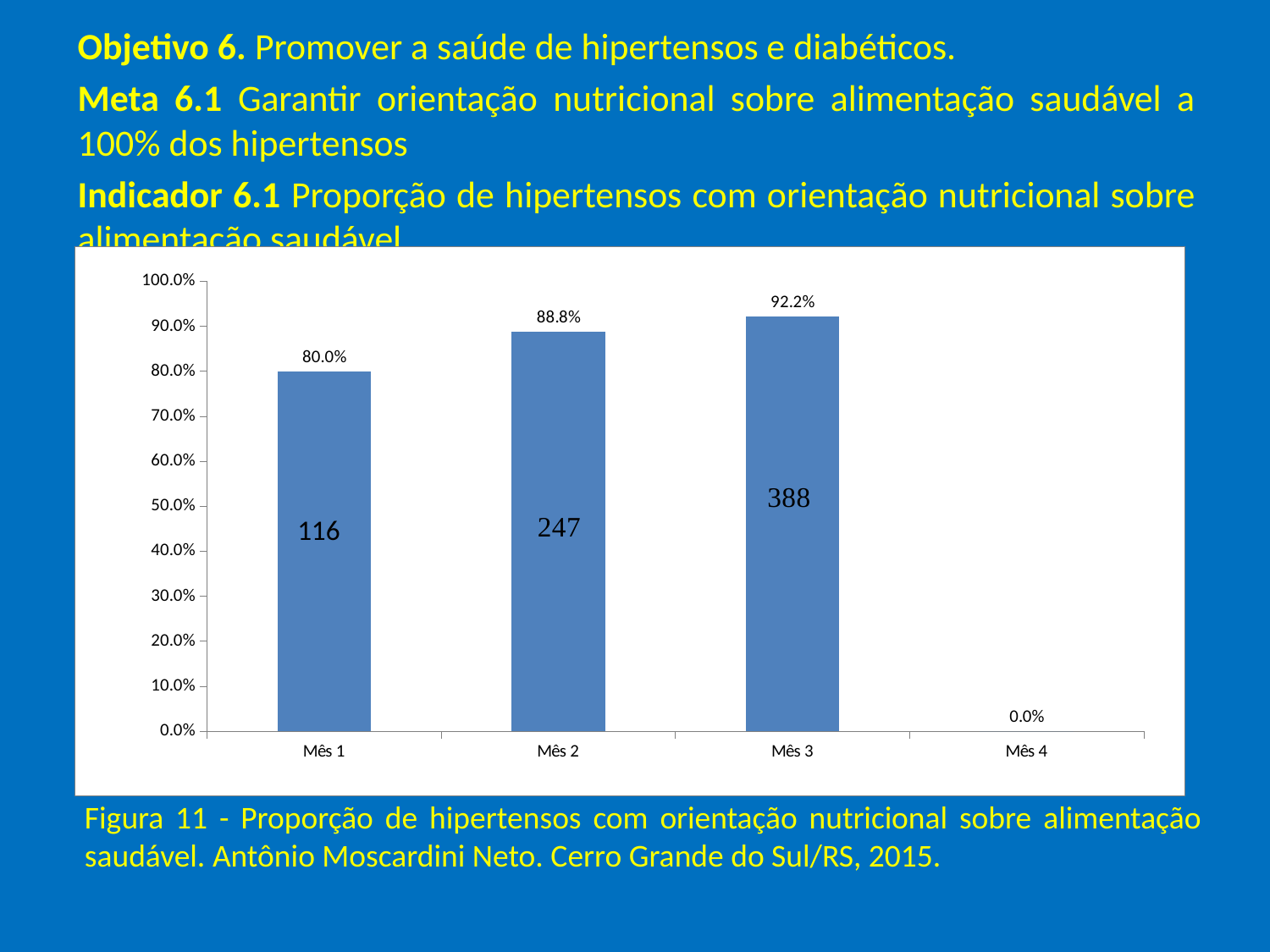
Which month has the lowest value? Mês 4 What is the difference between the values for Mês 3 and Mês 1? 12.2% What is the value for Mês 4? 0.0% What is the value for Mês 2? 88.8% What is the value for Mês 1? 80.0% Which is larger, the value for Mês 2 or the value for Mês 1? Mês 2 Which month has the highest value? Mês 3 What kind of chart is shown on the slide? bar chart What number is printed inside the bar for Mês 3? 388 Is the value for Mês 3 greater or less than 90.0%? greater How many months are shown on the x axis? 4 Do the values rise or fall from Mês 1 to Mês 3? rise